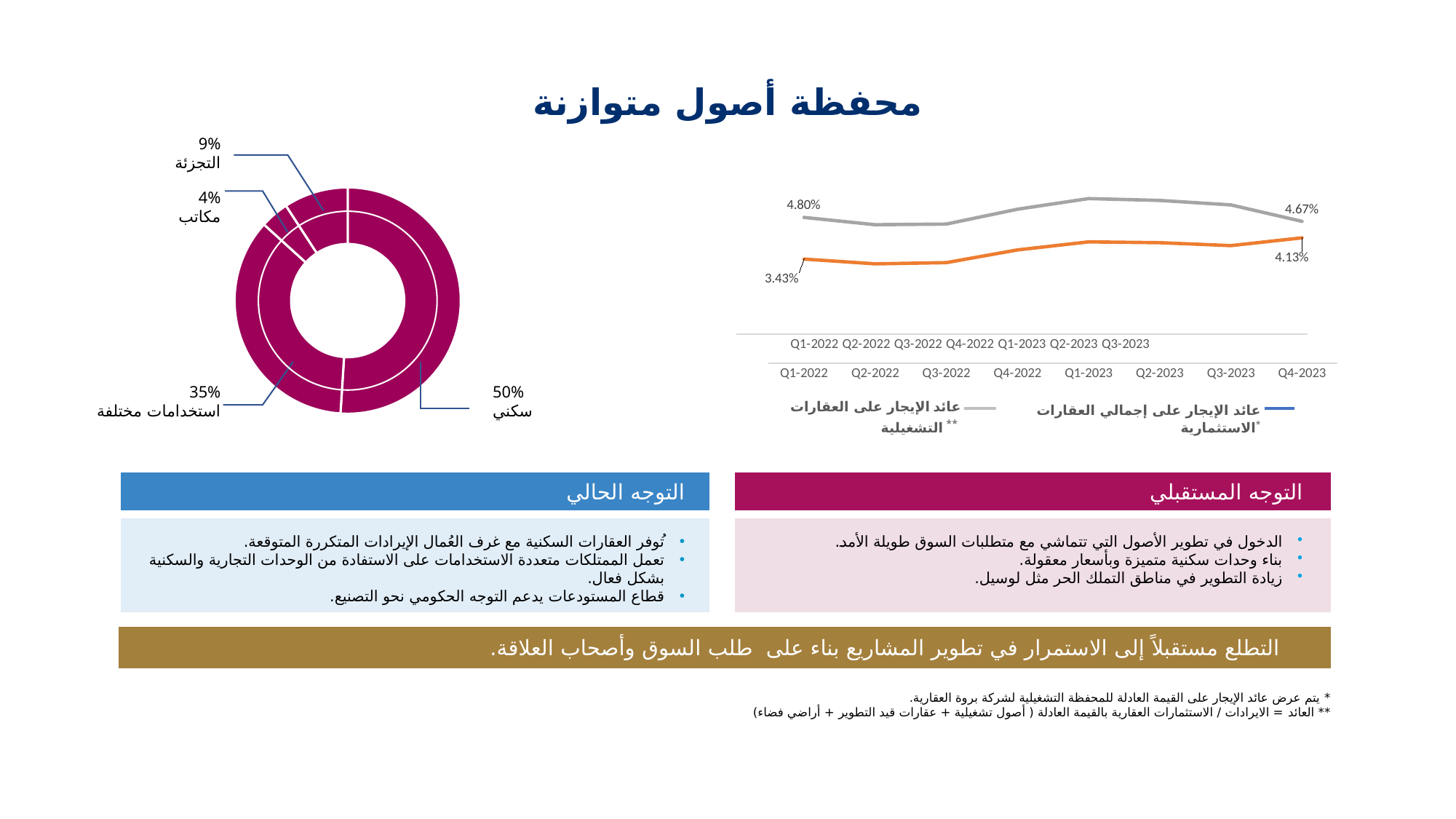
In the line chart on the right, what is the value of عائد الإيجار على إجمالي العقارات الاستثمارية at Q4-2023? 4.13% In the line chart on the right, how many quarters are shown on the x axis? 8 In the line chart on the right, which series has the higher value at Q4-2023: عائد الإيجار على العقارات التشغيلية or عائد الإيجار على إجمالي العقارات الاستثمارية? عائد الإيجار على العقارات التشغيلية In the donut chart on the left, what share does سكني have? 50% In the donut chart on the left, which category has the smallest share? مكاتب In the line chart on the right, how many series does the legend list? 2 In the donut chart on the left, how many categories are shown? 4 In the donut chart on the left, what share does مكاتب have? 4% In the donut chart on the left, which category has the largest share? سكني In the donut chart on the left, what is the difference in percentage points between سكني and استخدامات مختلفة? 15 In the line chart on the right, what is the value of عائد الإيجار على العقارات التشغيلية at Q1-2022? 4.80% In the donut chart on the left, what share does استخدامات مختلفة have? 35%